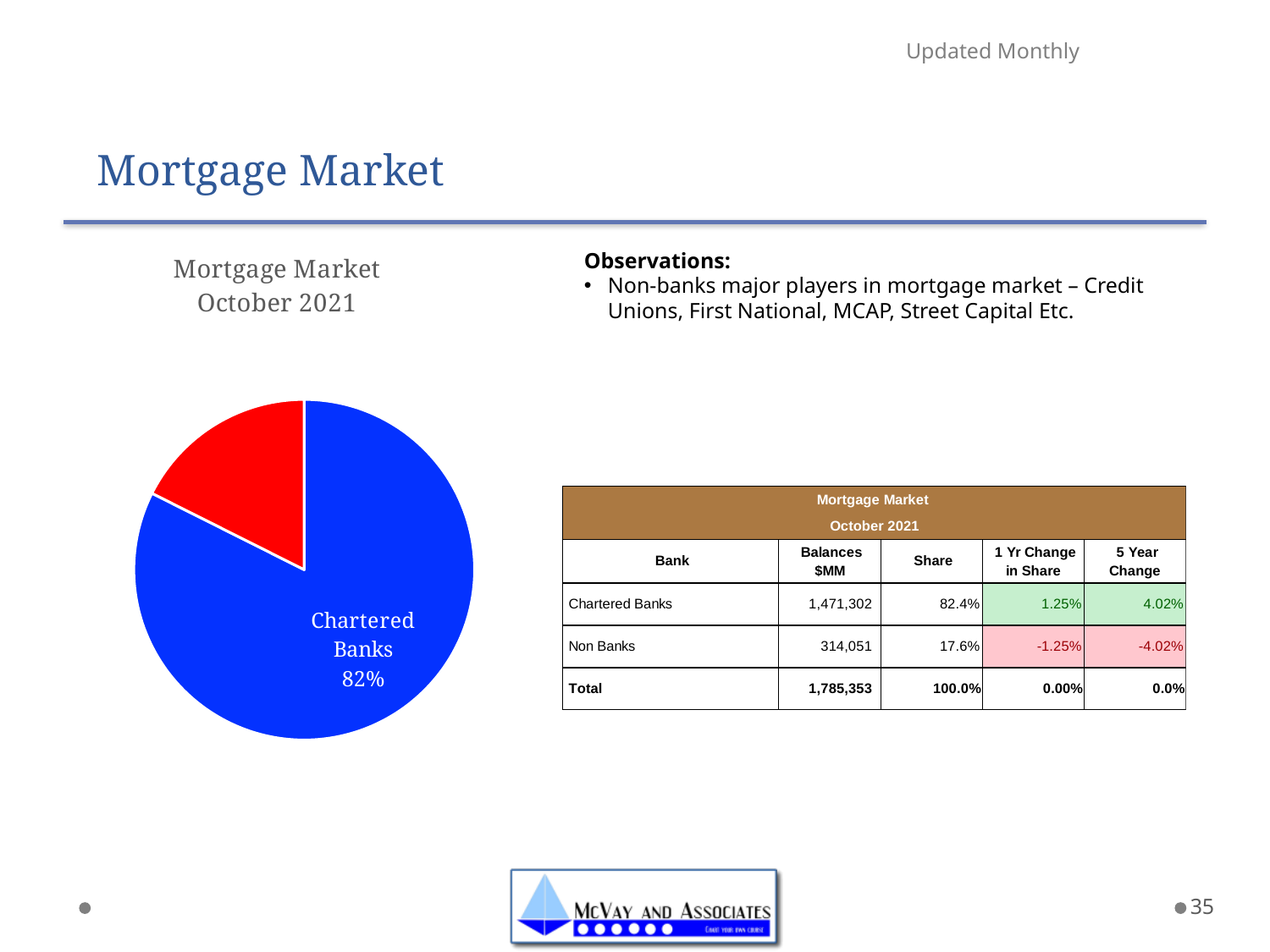
What colour is the Chartered Banks slice of the pie chart? blue What kind of chart is shown on the slide? pie chart What share of the pie is labelled for Chartered Banks? 82% Which slice of the pie chart is the largest? Chartered Banks Is the share for Chartered Banks greater or less than 50%? greater What is the title of the pie chart? Mortgage Market October 2021 How many slices does the pie chart have? 2 Which slice is larger, the blue slice or the red slice? the blue slice